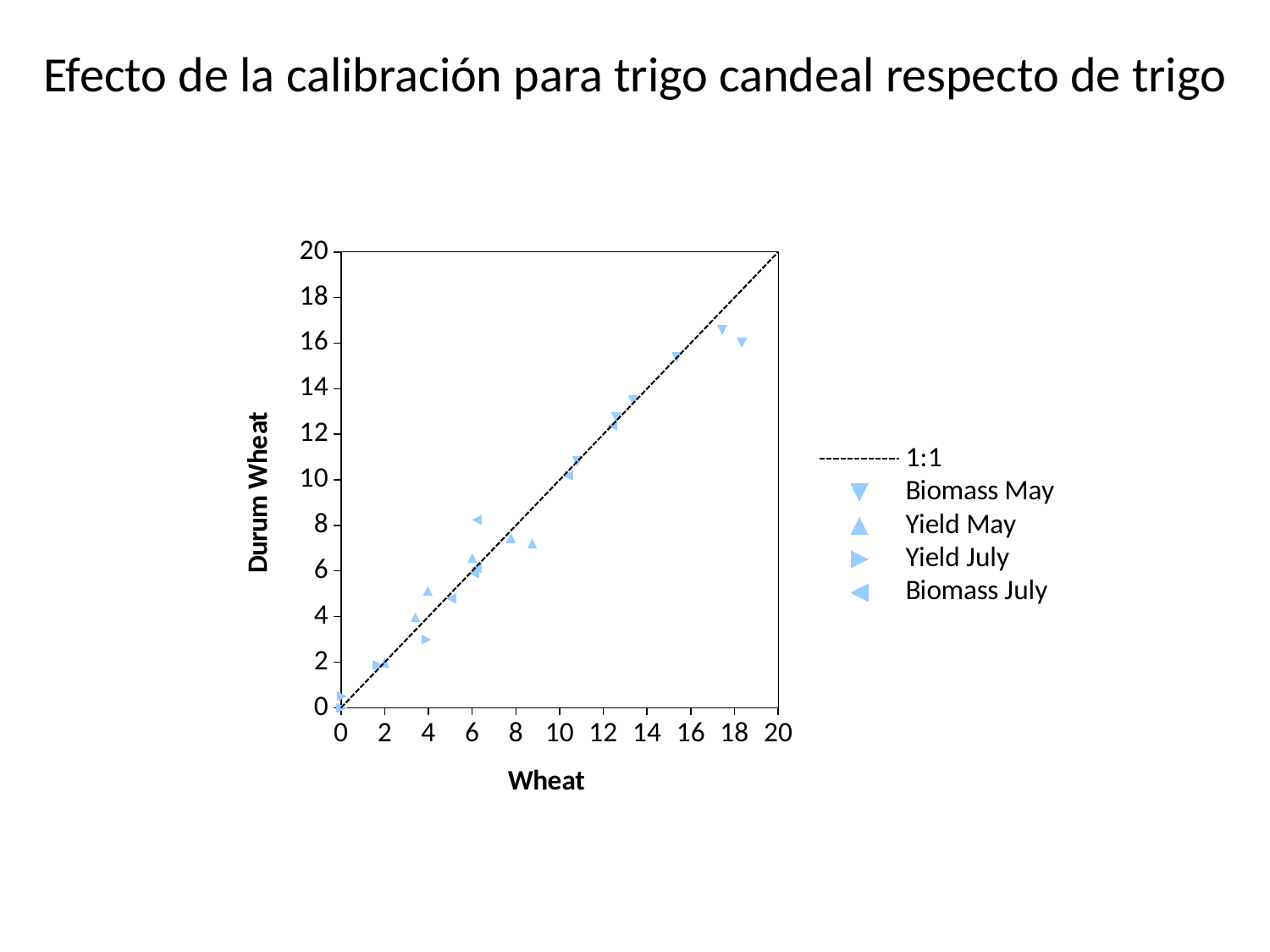
Which legend entry is drawn as a dashed line rather than a marker? 1:1 What is the title of the horizontal axis of the chart? Wheat Is the Durum Wheat value of the Yield July point near Wheat = 4 greater or less than 4? less Do the plotted Durum Wheat values generally rise or fall as the Wheat value increases along the x axis? rise What kind of chart is shown on the slide? scatter chart What is the title of the vertical axis of the chart? Durum Wheat Is the Durum Wheat value of the Yield May point near Wheat = 8.5 greater or less than 10? less How many entries does the chart legend list? 5 Is the Durum Wheat value of the rightmost Biomass May point (near Wheat = 18) greater or less than 14? greater